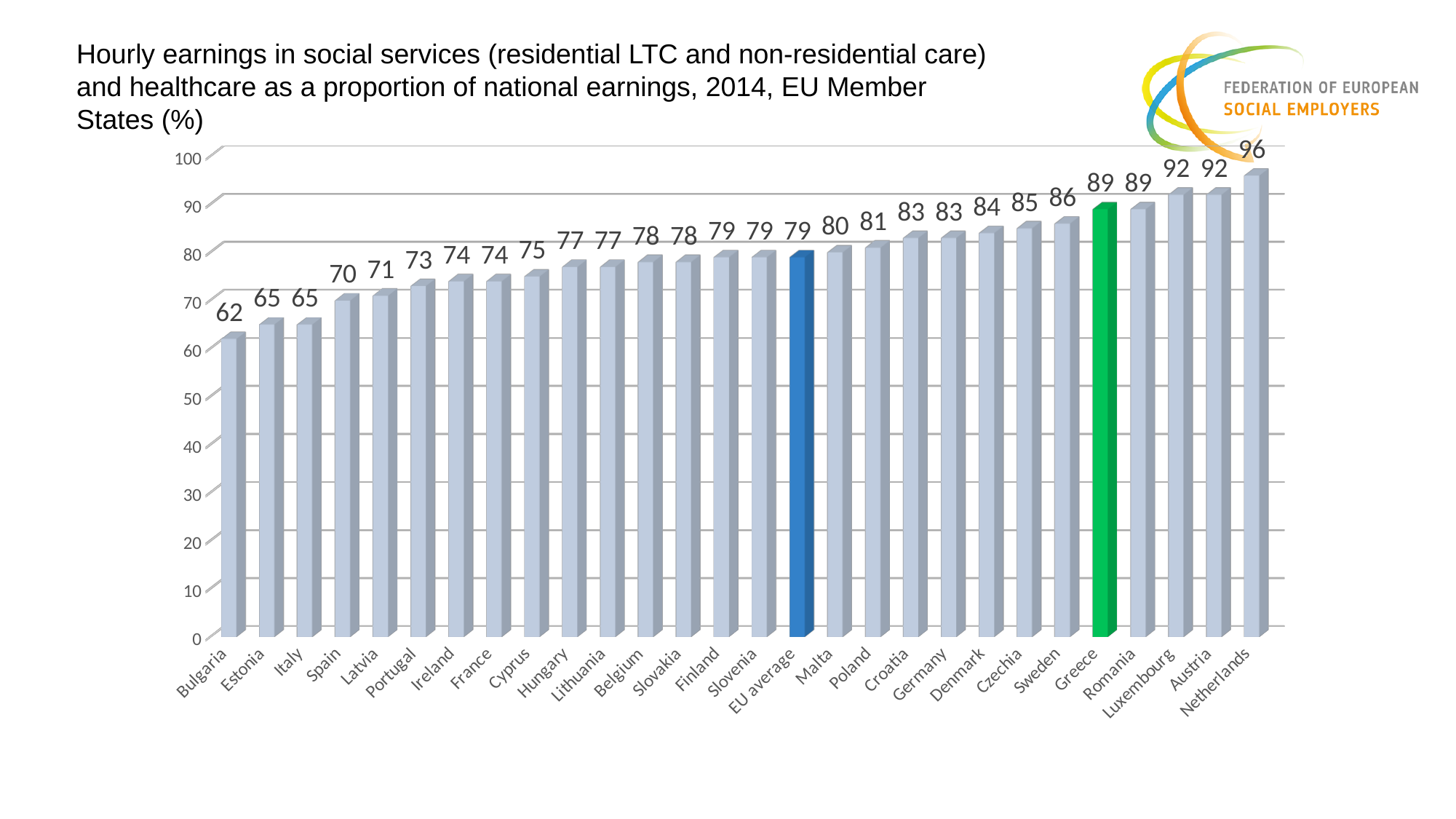
What is the difference between the values for Greece and the EU average? 10 What is the difference between the values for Netherlands and Bulgaria? 34 What is the value for Germany? 83 How many bars are shown in the chart? 28 What is the value for Greece? 89 Which country has the highest value? Netherlands Which country has the lowest value? Bulgaria What kind of chart is shown on the slide? Bar chart Which has a larger value, Sweden or Denmark? Sweden Do the values rise or fall from left to right along the x axis? Rise What is the value for the EU average? 79 What is the value for Bulgaria? 62